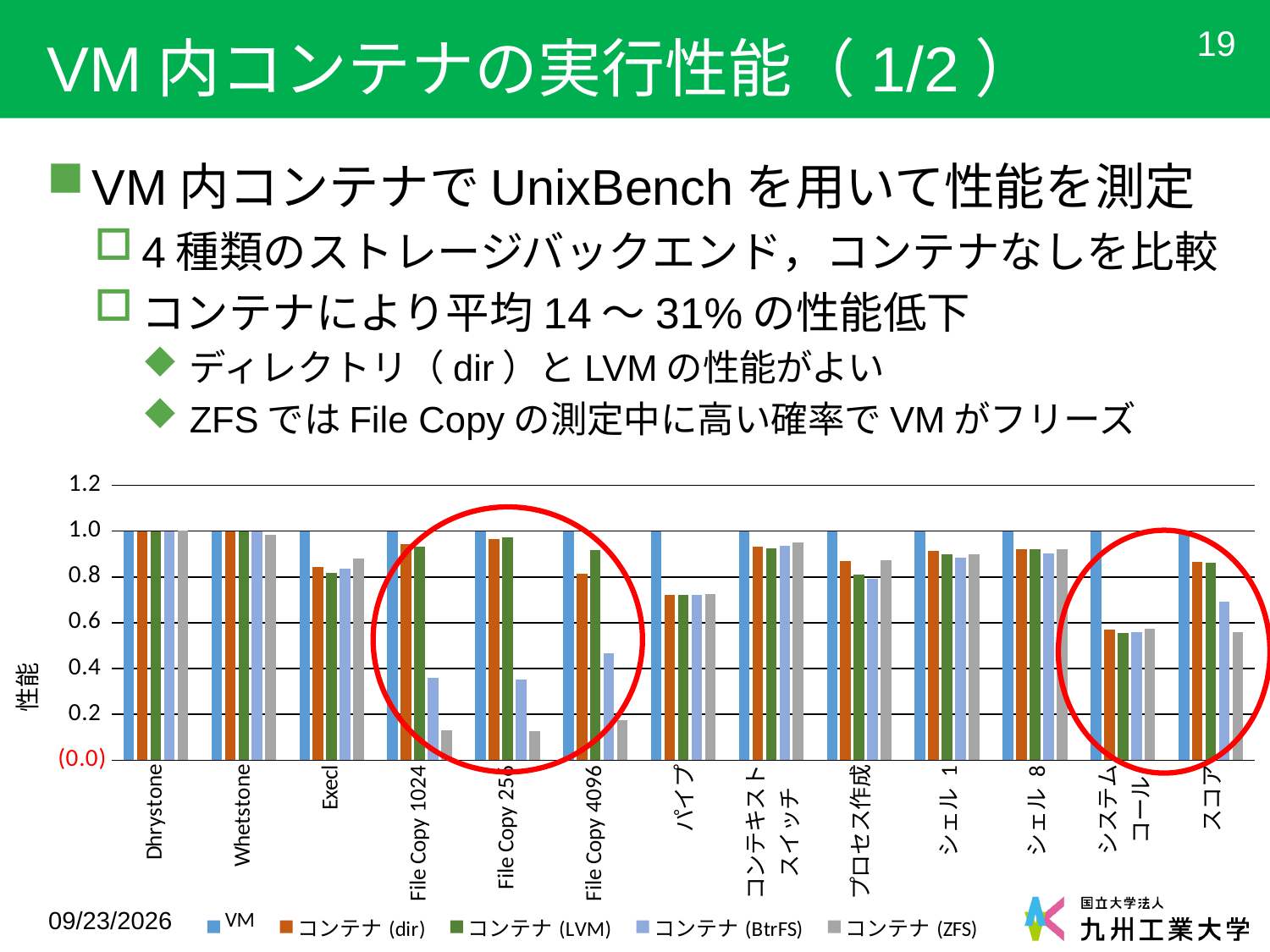
For File Copy 1024, which is larger: コンテナ (dir) or コンテナ (BtrFS)? コンテナ (dir) How many categories are shown along the x axis of the chart? 13 What is the value of the VM series for Dhrystone? 1.0 For File Copy 1024, which series has the lowest value? コンテナ (ZFS) Is the value of コンテナ (BtrFS) for File Copy 256 greater or less than 0.6? less What is the label on the y axis of the chart? 性能 Is the value of コンテナ (dir) for パイプ greater or less than 0.8? less Is the value of コンテナ (BtrFS) for File Copy 4096 greater or less than 0.6? less How many series does the chart legend list? 5 What kind of chart is shown on the slide? bar chart